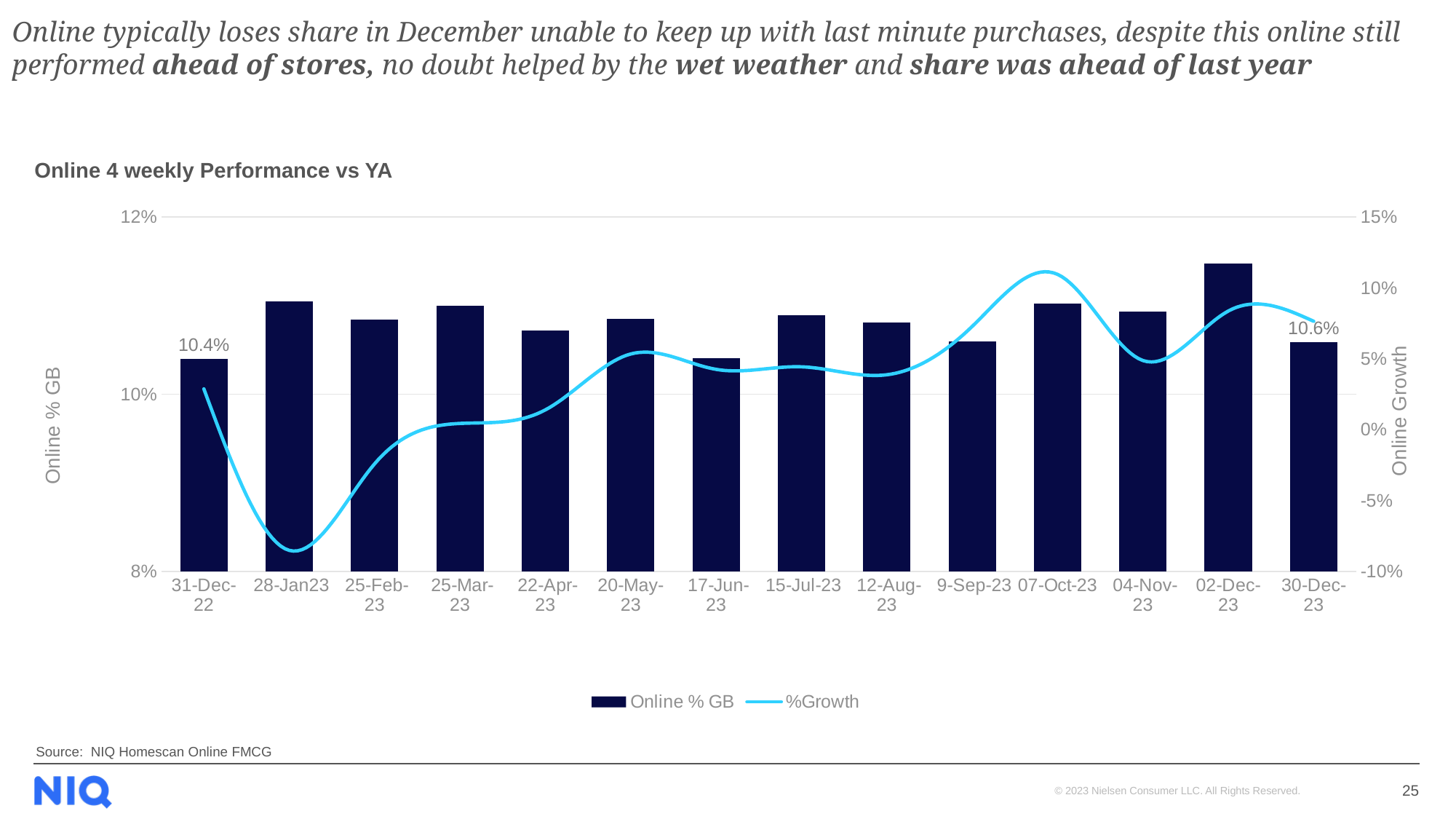
Is the Online % GB value for 28-Jan23 greater or less than 10%? greater How many series does the legend list? 2 Which period has the highest Online % GB bar? 02-Dec-23 How many 4-weekly periods are shown on the x axis? 14 Is the %Growth value for 07-Oct-23 greater or less than 5%? greater What is the Online % GB value for 30-Dec-23? 10.6% What is the difference between the Online % GB values for 30-Dec-23 and 31-Dec-22? 0.2% What is the title of the chart? Online 4 weekly Performance vs YA Which has the larger Online % GB bar, 02-Dec-23 or 30-Dec-23? 02-Dec-23 What is the Online % GB value for 31-Dec-22? 10.4% Is the %Growth value for 28-Jan23 greater or less than -5%? less